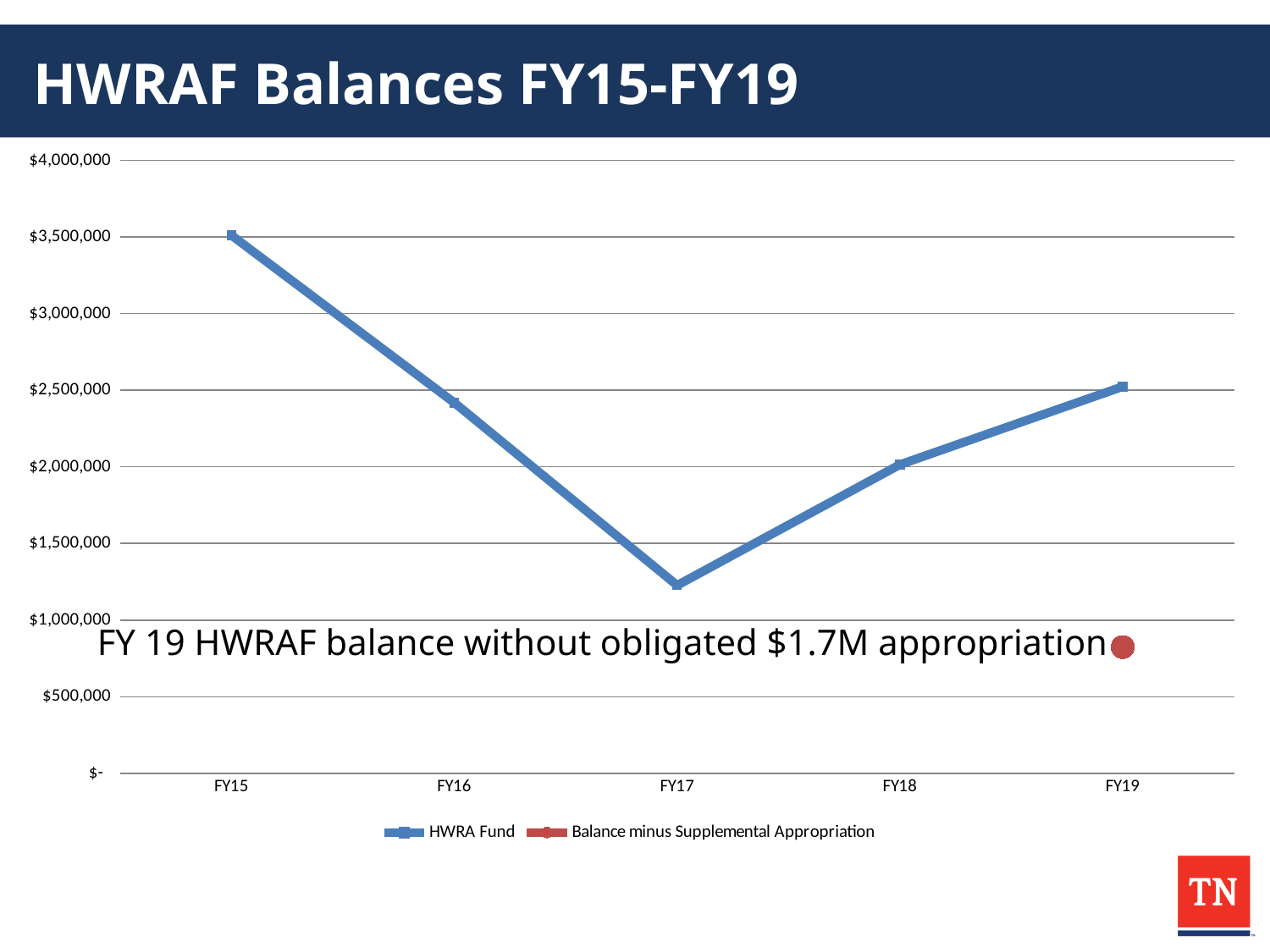
Which is larger, the HWRA Fund balance in FY15 or in FY19? FY15 How many series does the legend list? 2 What kind of chart is shown on the slide? Line chart How many fiscal years are shown on the x axis? 5 Is the HWRA Fund value for FY17 greater or less than $1,500,000? less In which fiscal year is the HWRA Fund balance highest? FY15 Is the HWRA Fund value for FY19 greater or less than $2,000,000? greater Is the Balance minus Supplemental Appropriation point for FY19 greater or less than $1,000,000? less What is the title of the chart? HWRAF Balances FY15-FY19 In which fiscal year is the HWRA Fund balance lowest? FY17 How does the HWRA Fund balance change from FY15 to FY17? It falls